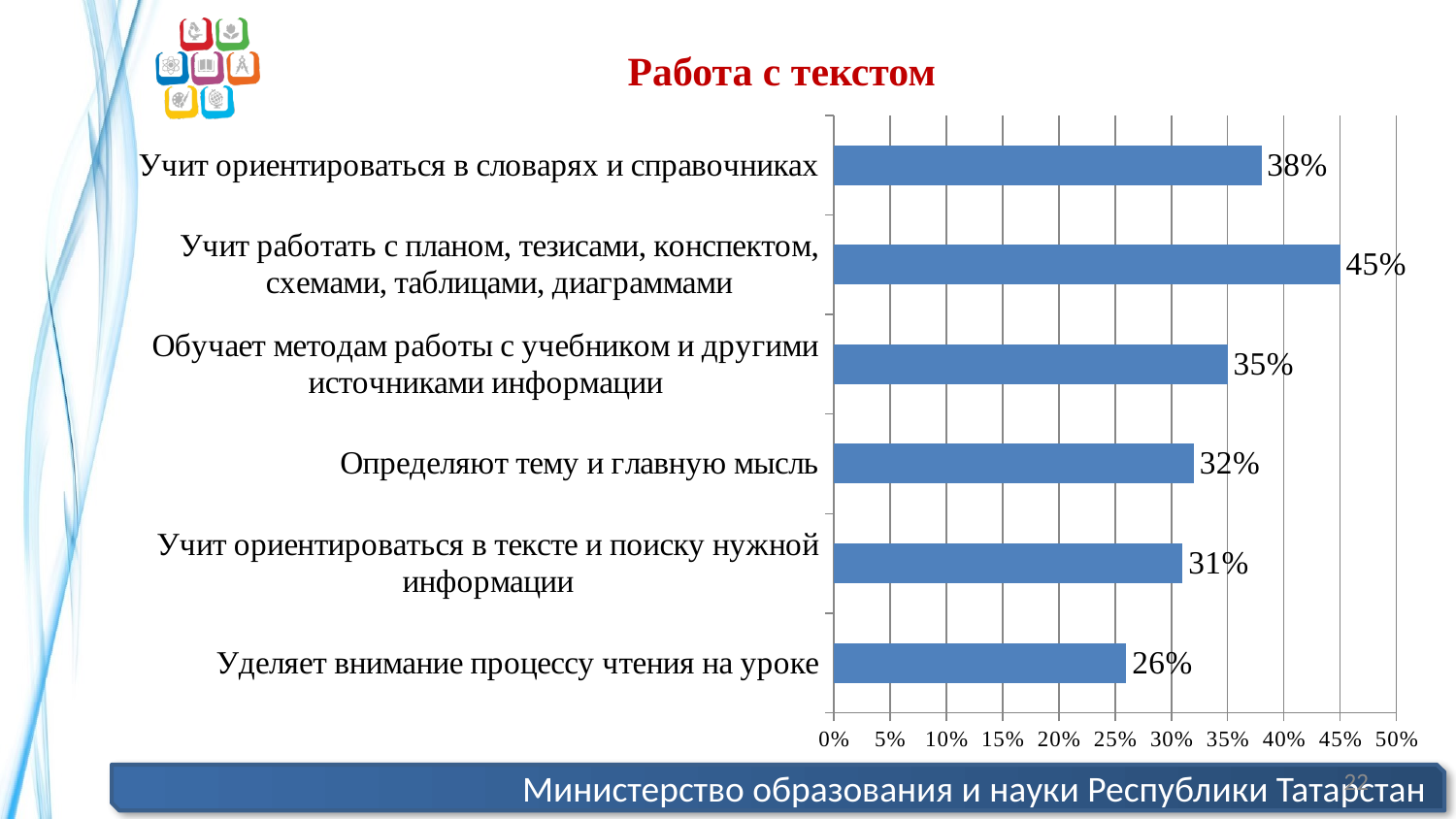
How many categories are shown in the chart? 6 What kind of chart is shown on the slide? bar chart What is the difference between "Учит ориентироваться в словарях и справочниках" and "Обучает методам работы с учебником и другими источниками информации"? 3% Which category has the highest value? Учит работать с планом, тезисами, конспектом, схемами, таблицами, диаграммами Is the value for "Обучает методам работы с учебником и другими источниками информации" greater or less than 30%? greater What is the difference between the highest and lowest values? 19% Which is larger: "Определяют тему и главную мысль" or "Учит ориентироваться в тексте и поиску нужной информации"? Определяют тему и главную мысль What is the value for "Учит ориентироваться в словарях и справочниках"? 38% What is the value for "Определяют тему и главную мысль"? 32% What is the title of the chart? Работа с текстом Which category has the lowest value? Уделяет внимание процессу чтения на уроке What is the value for "Уделяет внимание процессу чтения на уроке"? 26%